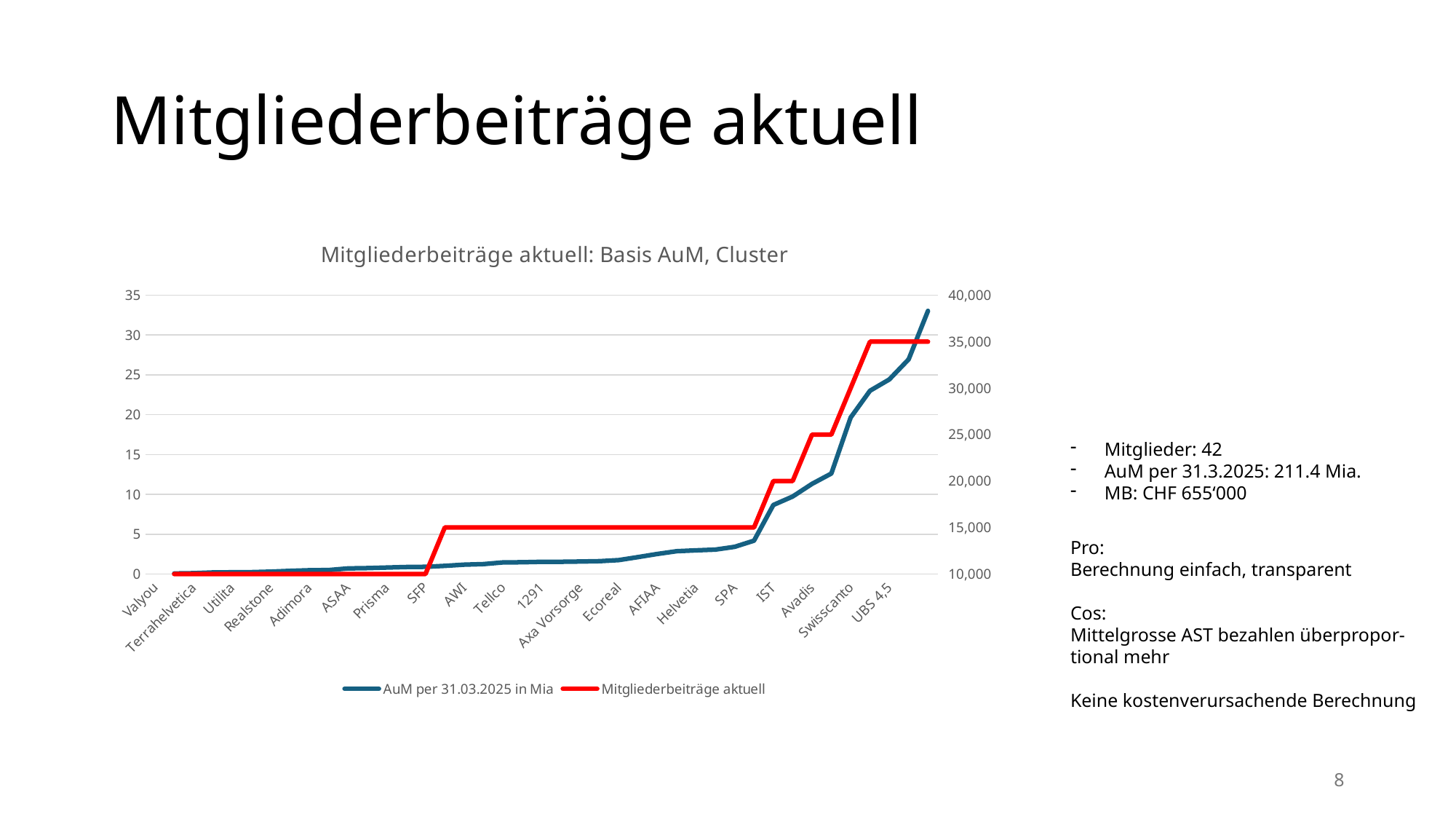
What is the value of Mitgliederbeiträge aktuell for Tellco? 15,000 Which has the larger AuM per 31.03.2025 in Mia, Swisscanto or Helvetia? Swisscanto Is the AuM per 31.03.2025 in Mia value for UBS 4,5 greater or less than 30? less How many series does the chart legend list? 2 Do the AuM per 31.03.2025 in Mia values rise or fall along the x axis? rise What is the value of Mitgliederbeiträge aktuell for UBS 4,5? 35,000 What is the title of the chart? Mitgliederbeiträge aktuell: Basis AuM, Cluster Is the AuM per 31.03.2025 in Mia value for Tellco greater or less than 5? less Which series is drawn in red? Mitgliederbeiträge aktuell What kind of chart is shown on the slide? line chart